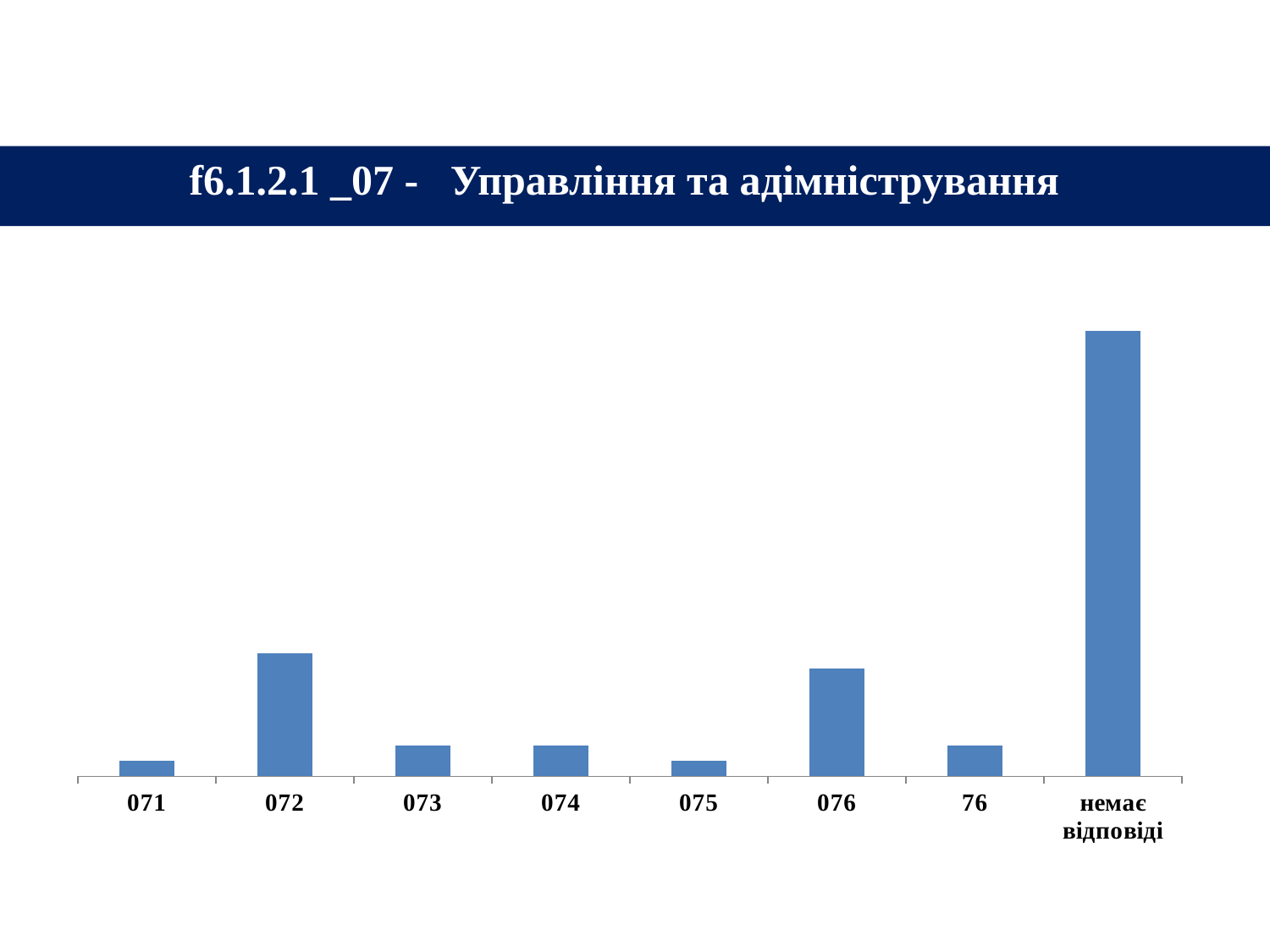
What is the label of the last category on the x axis? немає відповіді Which bar is taller, 'немає відповіді' or 072? немає відповіді Which bar is taller, 073 or 075? 073 Which bar is taller, 076 or 074? 076 How many categories are shown on the x axis of the chart? 8 Which category has the highest bar in the chart? немає відповіді What kind of chart is shown on the slide? bar chart Which of the numbered categories (071 to 76) has the highest bar? 072 What is the title shown above the chart? f6.1.2.1 _07 - Управління та адіміністрування